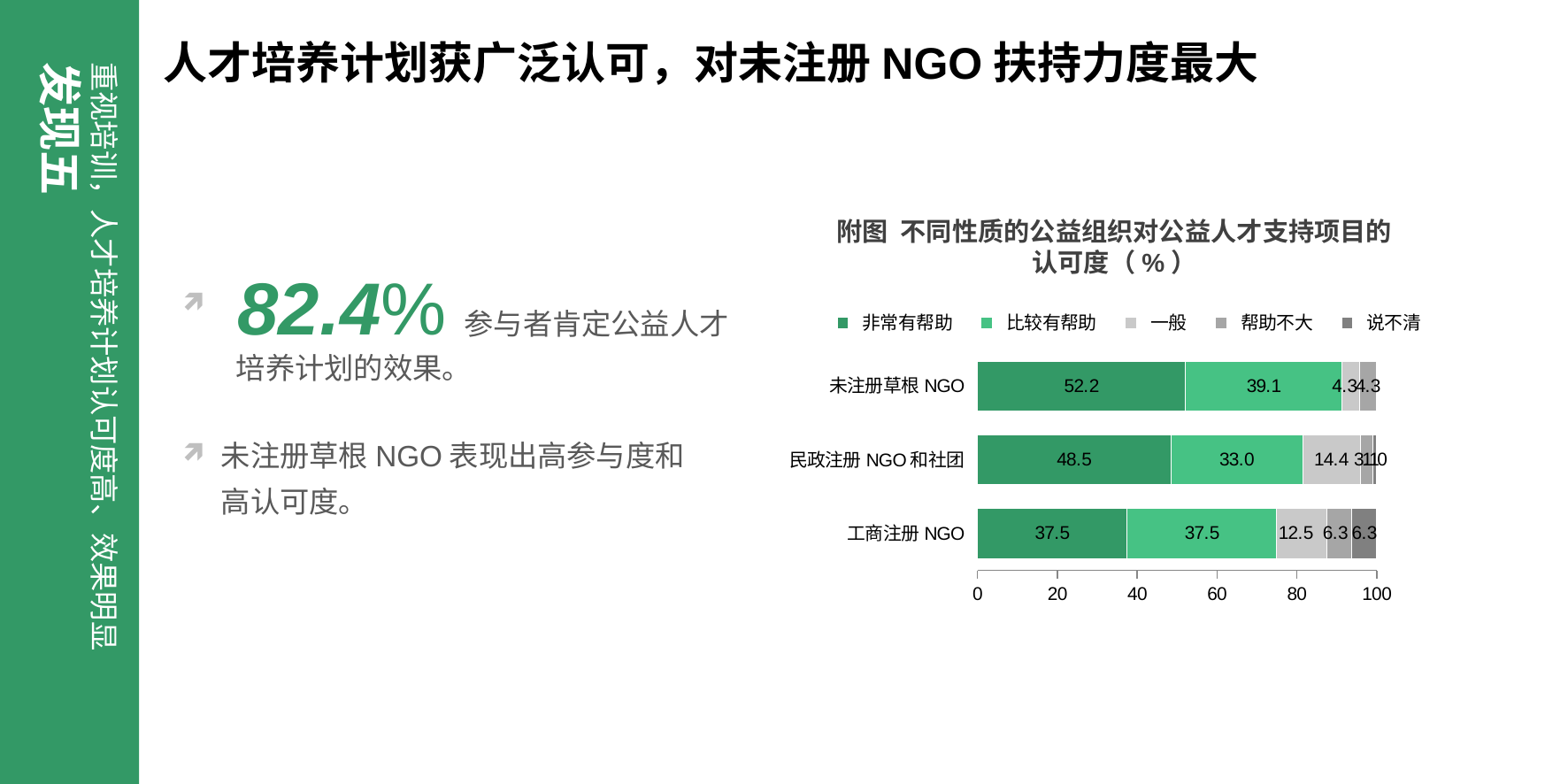
Which is larger: the 比较有帮助 value for 未注册草根 NGO or for 工商注册 NGO? 未注册草根 NGO What is the 非常有帮助 value for 未注册草根 NGO? 52.2 How many organization categories are plotted in the chart? 3 What is the 比较有帮助 value for 民政注册 NGO 和社团? 33.0 Which organization category has the highest 非常有帮助 value? 未注册草根 NGO How many series does the chart legend list? 5 What is the 一般 value for 工商注册 NGO? 12.5 What type of chart is shown on the slide? stacked bar chart What is the 一般 value for 民政注册 NGO 和社团? 14.4 Which organization category has the lowest 非常有帮助 value? 工商注册 NGO What is the difference between the 非常有帮助 values for 未注册草根 NGO and 工商注册 NGO? 14.7 What is the title of the chart? 附图 不同性质的公益组织对公益人才支持项目的认可度（%）